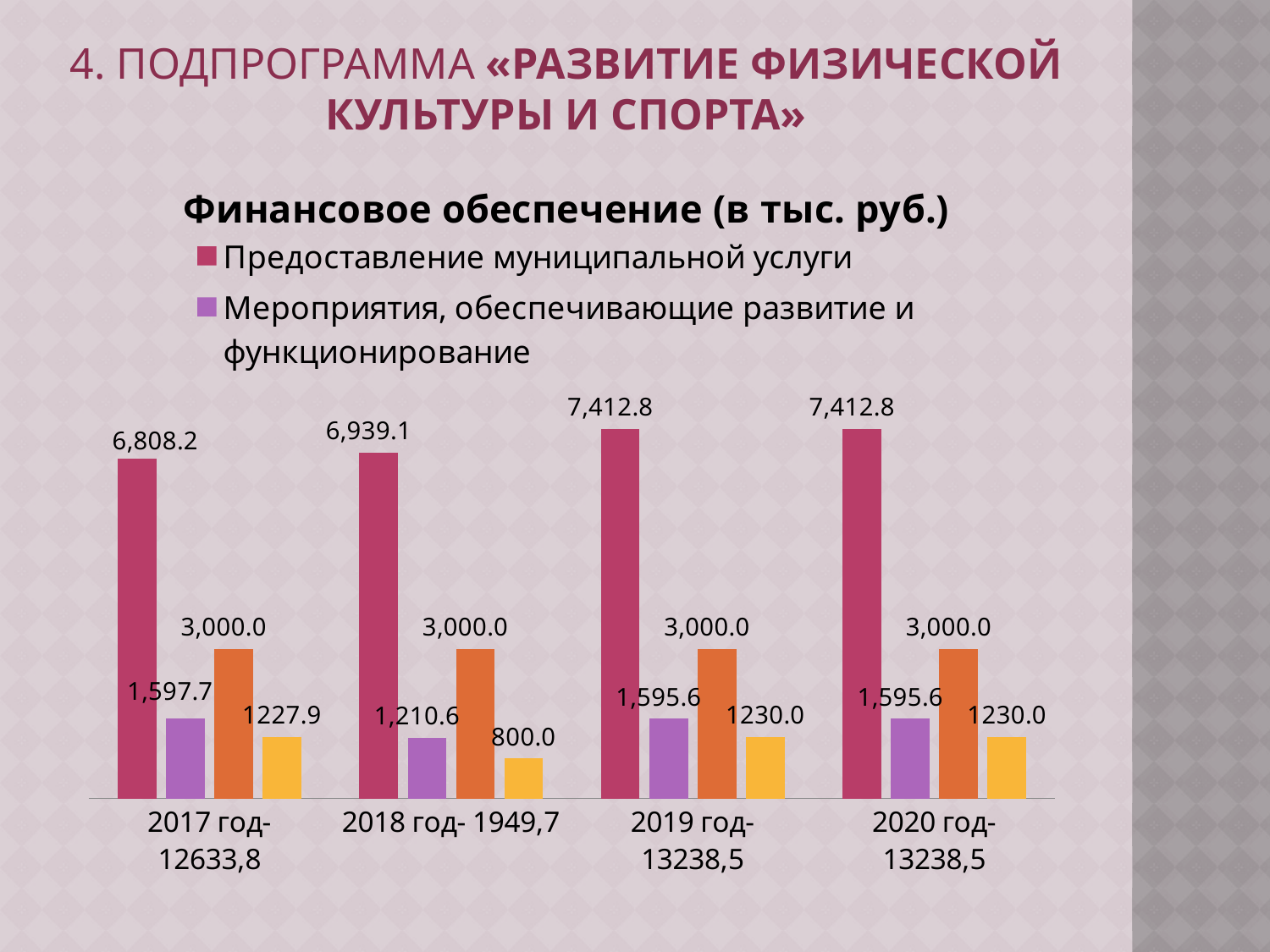
What is the value of «Мероприятия, обеспечивающие развитие и функционирование» for 2018 год? 1,210.6 What is the value of «Предоставление муниципальной услуги» for 2019 год? 7,412.8 How many series does the legend list? 2 Which is larger for «Предоставление муниципальной услуги»: 2019 год or 2017 год? 2019 год What kind of chart is shown on the slide? Bar chart By how much does «Предоставление муниципальной услуги» in 2018 год exceed its value in 2017 год? 130.9 What is the title of the chart? Финансовое обеспечение (в тыс. руб.) In which year is the value of «Мероприятия, обеспечивающие развитие и функционирование» the lowest? 2018 год What is the value of «Предоставление муниципальной услуги» for 2017 год? 6,808.2 In which year is the value of «Предоставление муниципальной услуги» the lowest? 2017 год How many year categories are shown on the x axis? 4 What is the difference between «Мероприятия, обеспечивающие развитие и функционирование» in 2017 год and in 2018 год? 387.1